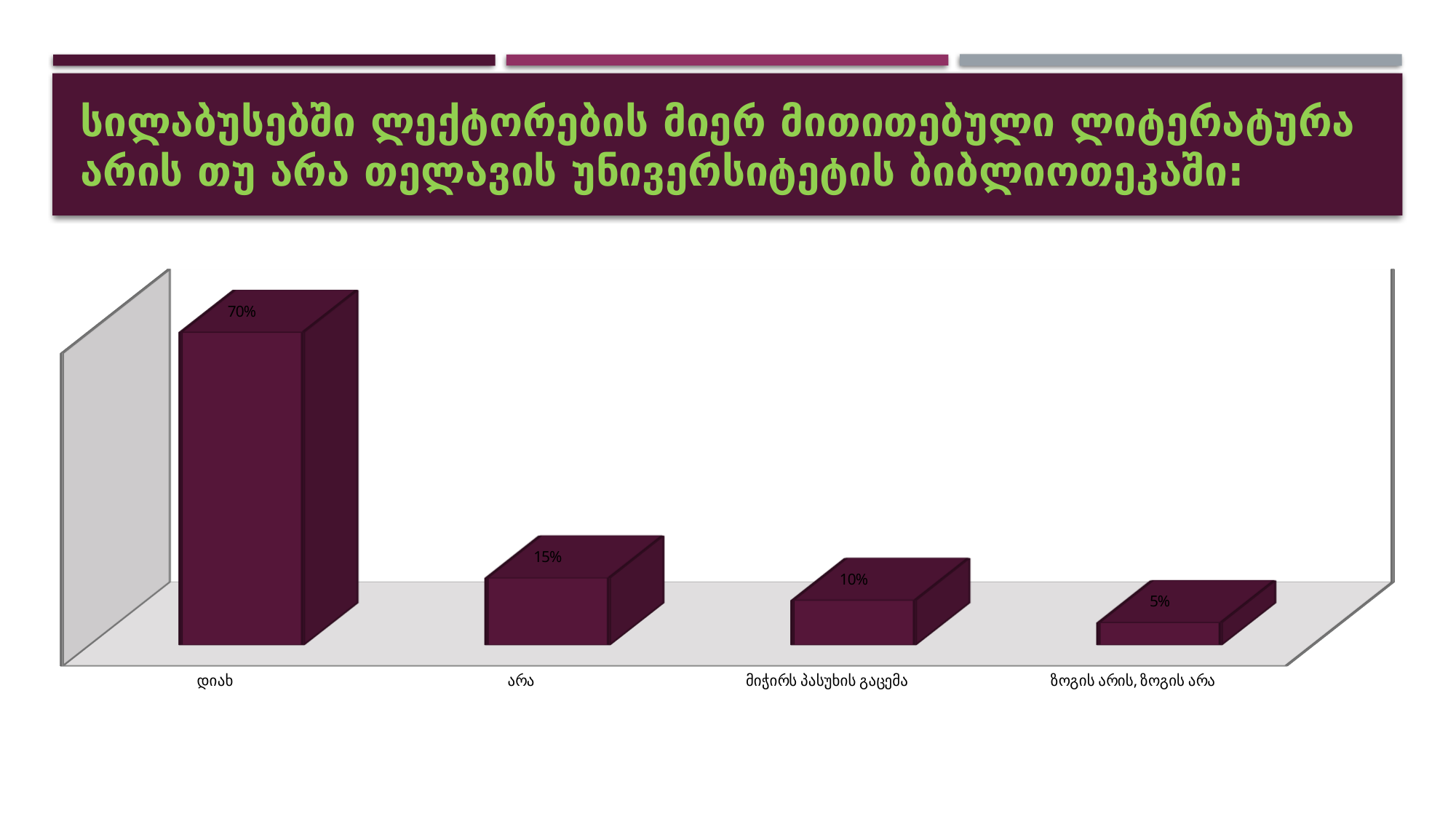
What is the difference between the values for "დიახ" and "არა"? 55% Which category has the lowest value? ზოგის არის, ზოგის არა What kind of chart is shown on the slide? Bar chart How many categories are shown in the chart? 4 What is the value for the category "არა"? 15% What is the value for the category "მიჭირს პასუხის გაცემა"? 10% What is the value for the category "დიახ"? 70% What is the value for the category "ზოგის არის, ზოგის არა"? 5% Do the values rise or fall from left to right across the categories? Fall What is the difference between the values for "მიჭირს პასუხის გაცემა" and "ზოგის არის, ზოგის არა"? 5% Which is larger, the value for "არა" or the value for "მიჭირს პასუხის გაცემა"? არა Which category has the highest value? დიახ